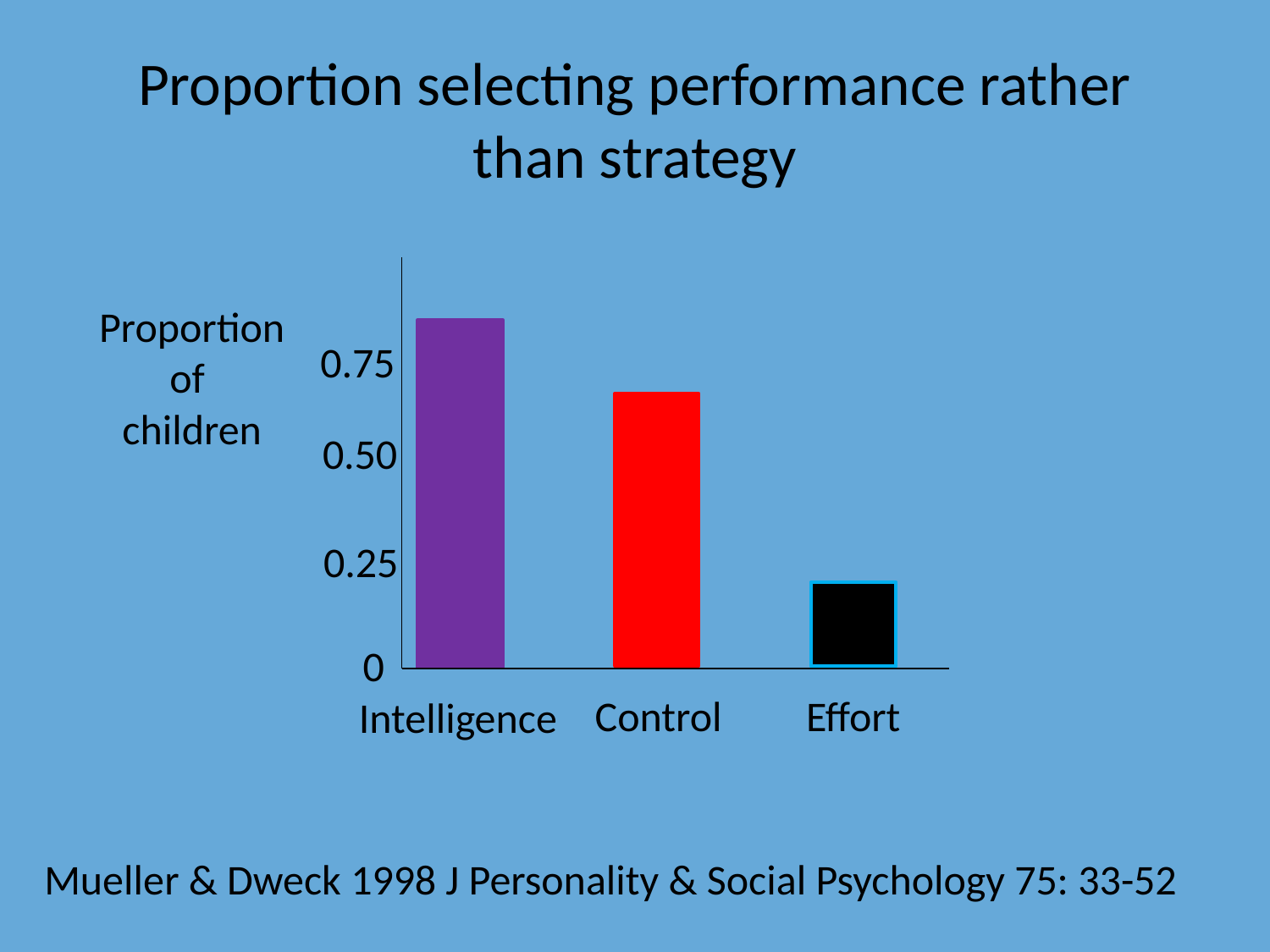
What is the title of the chart? Proportion selecting performance rather than strategy How many categories are plotted in the chart? 3 Which category has the lowest proportion of children? Effort Is the value for Control greater or less than 0.75? less Which category has the highest proportion of children? Intelligence Which is larger, the value for Control or the value for Effort? Control Is the value for Intelligence greater or less than 0.75? greater Do the values rise or fall moving from Intelligence to Effort along the x axis? fall Which is larger, the value for Intelligence or the value for Control? Intelligence Is the value for Effort greater or less than 0.25? less What kind of chart is shown on the slide? bar chart